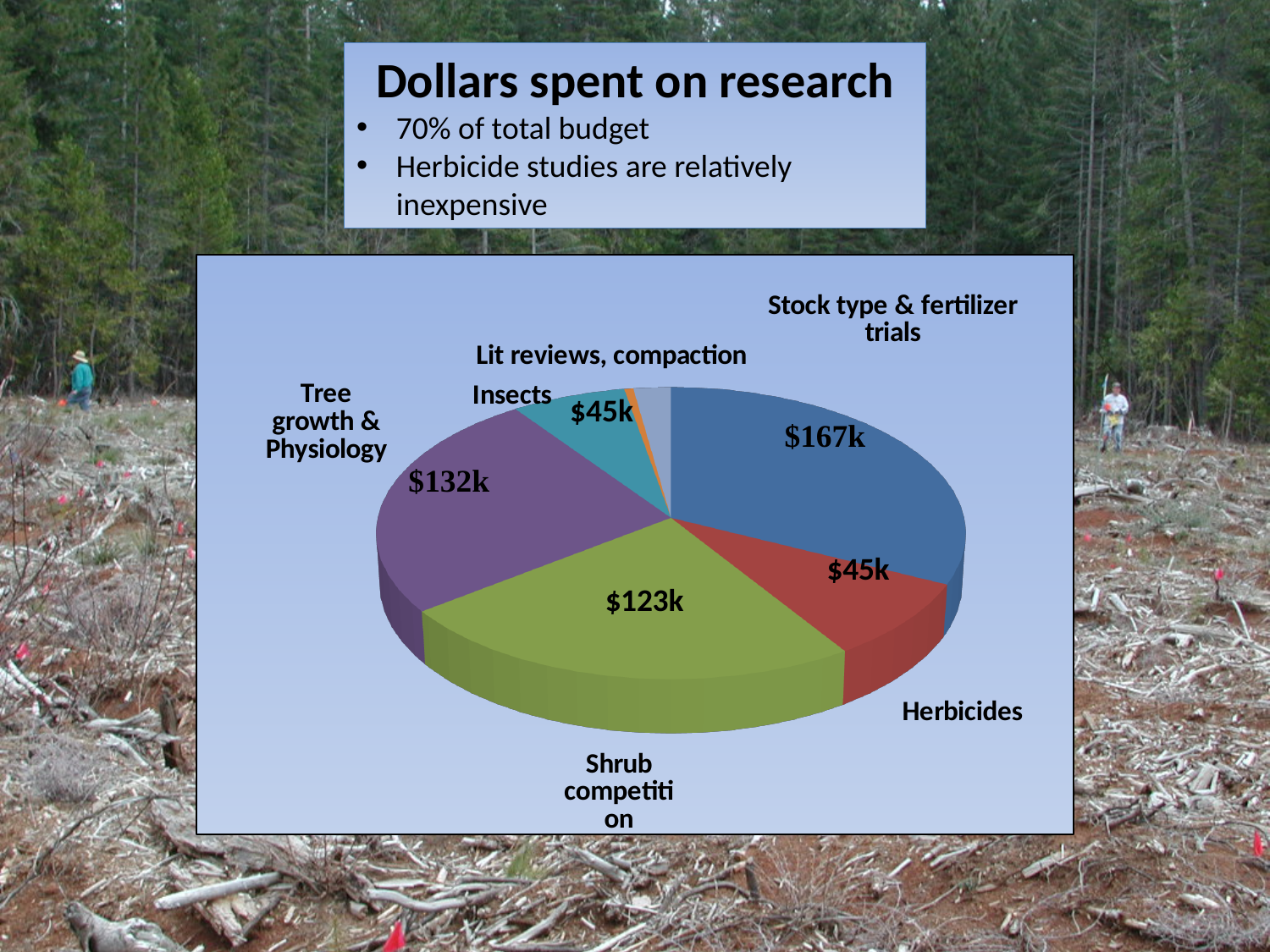
What is the value shown for Tree growth & Physiology? $132k What is the difference between the value for Stock type & fertilizer trials and the value for Shrub competition? $44k How many dollars were spent on Stock type & fertilizer trials? $167k Which is larger, the value for Stock type & fertilizer trials or the value for Herbicides? Stock type & fertilizer trials What is the value shown for Herbicides? $45k Which category received the most research dollars? Stock type & fertilizer trials What is the difference between the value for Tree growth & Physiology and the value for Insects? $87k Which is larger, the value for Tree growth & Physiology or the value for Shrub competition? Tree growth & Physiology What is the value shown for Insects? $45k What is the value shown for Shrub competition? $123k What kind of chart is shown on the slide? pie chart What is the title of the slide containing the chart? Dollars spent on research